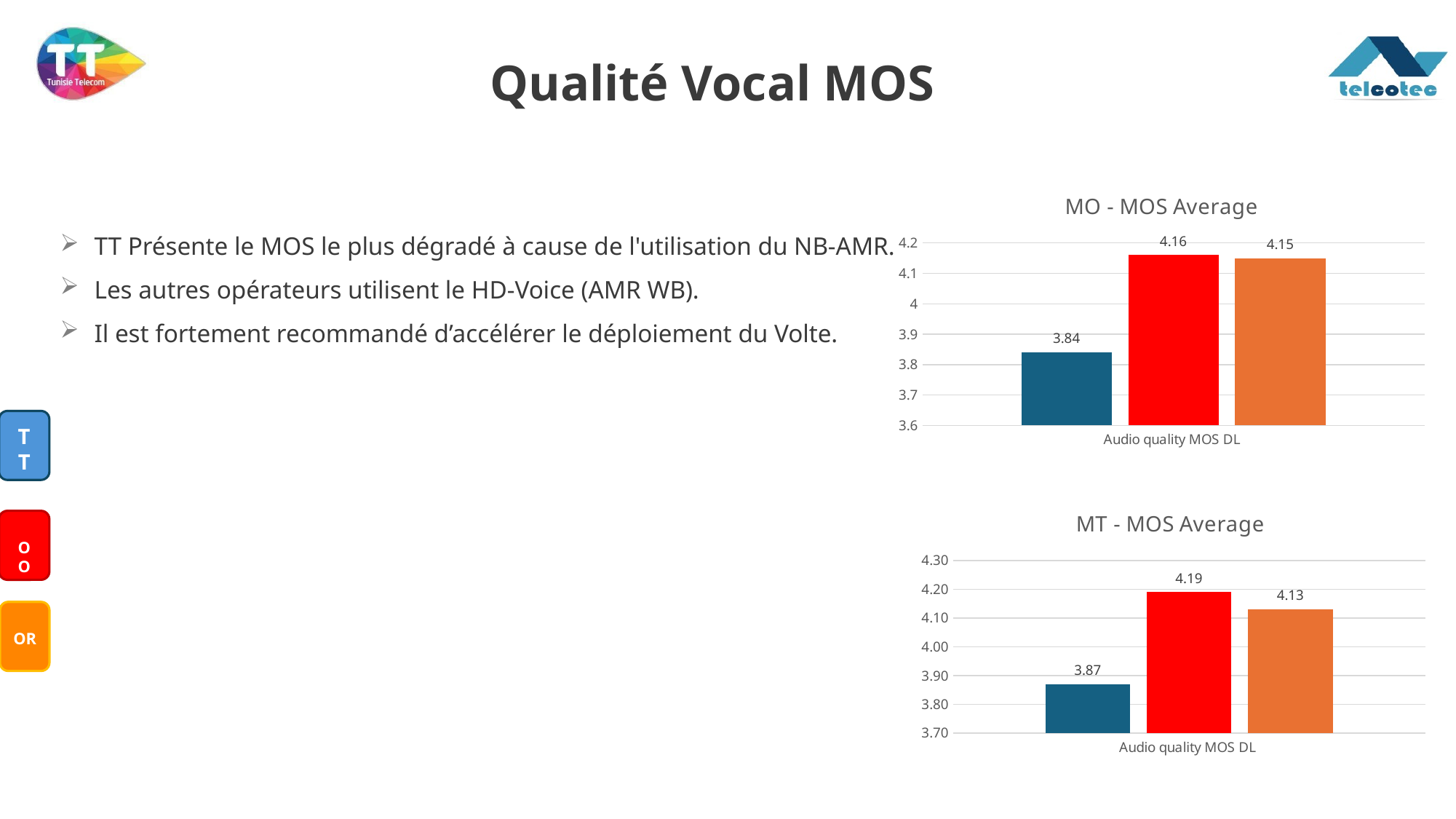
In the MO - MOS Average chart, is the value of the blue bar greater or less than 3.9? less In the MT - MOS Average chart, what is the value of the orange bar? 4.13 In the MT - MOS Average chart, what is the value of the blue bar? 3.87 In the MO - MOS Average chart, what is the difference between the red bar and the orange bar? 0.01 In the MT - MOS Average chart, which bar has the highest value? The red bar (4.19) How many bars are shown in the MO - MOS Average chart? 3 In the MO - MOS Average chart, what is the value of the red bar? 4.16 In the MO - MOS Average chart, what is the value of the blue bar? 3.84 In the MT - MOS Average chart, which is larger, the red bar or the orange bar? The red bar In the MO - MOS Average chart, which bar has the lowest value? The blue bar (3.84) In the MT - MOS Average chart, what is the difference between the red bar and the blue bar? 0.32 What type of chart is the MT - MOS Average chart? Bar chart